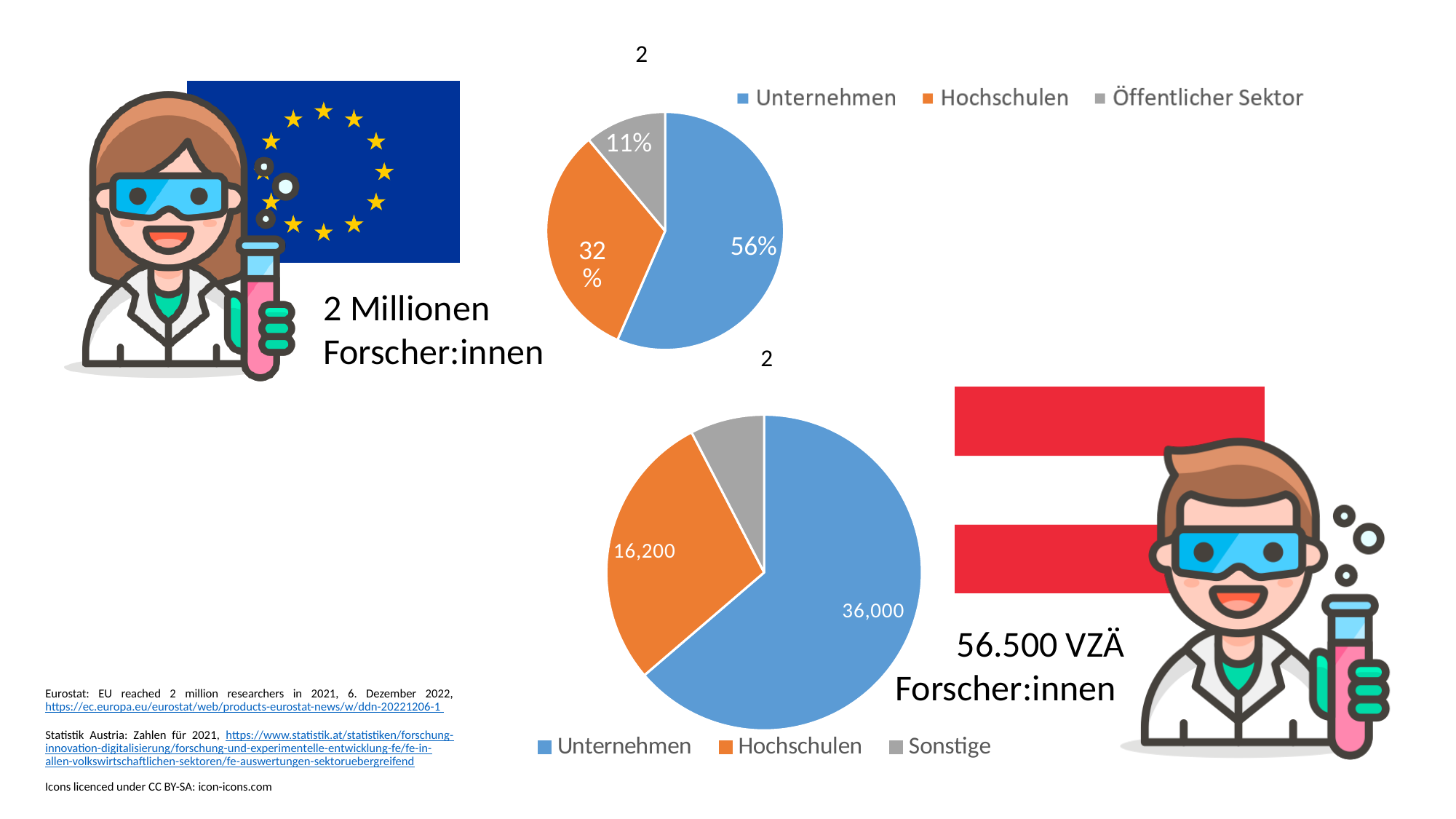
In the bottom pie chart, what is the value shown for Unternehmen? 36,000 In the bottom pie chart, what is the value shown for Hochschulen? 16,200 How many entries does the legend of the top pie chart list? 3 In the top pie chart, what is the value shown for Öffentlicher Sektor? 11% In the bottom pie chart, which category has the smallest slice? Sonstige In the top pie chart, which category has the smallest slice? Öffentlicher Sektor In the top pie chart, what is the value shown for Unternehmen? 56% In the top pie chart, what is the difference in percentage points between Unternehmen and Hochschulen? 24 percentage points In the top pie chart, what is the value shown for Hochschulen? 32% What kind of chart is the top chart on the slide? Pie chart In the bottom pie chart, what is the difference between the values for Unternehmen and Hochschulen? 19,800 In the top pie chart, which category has the largest slice? Unternehmen